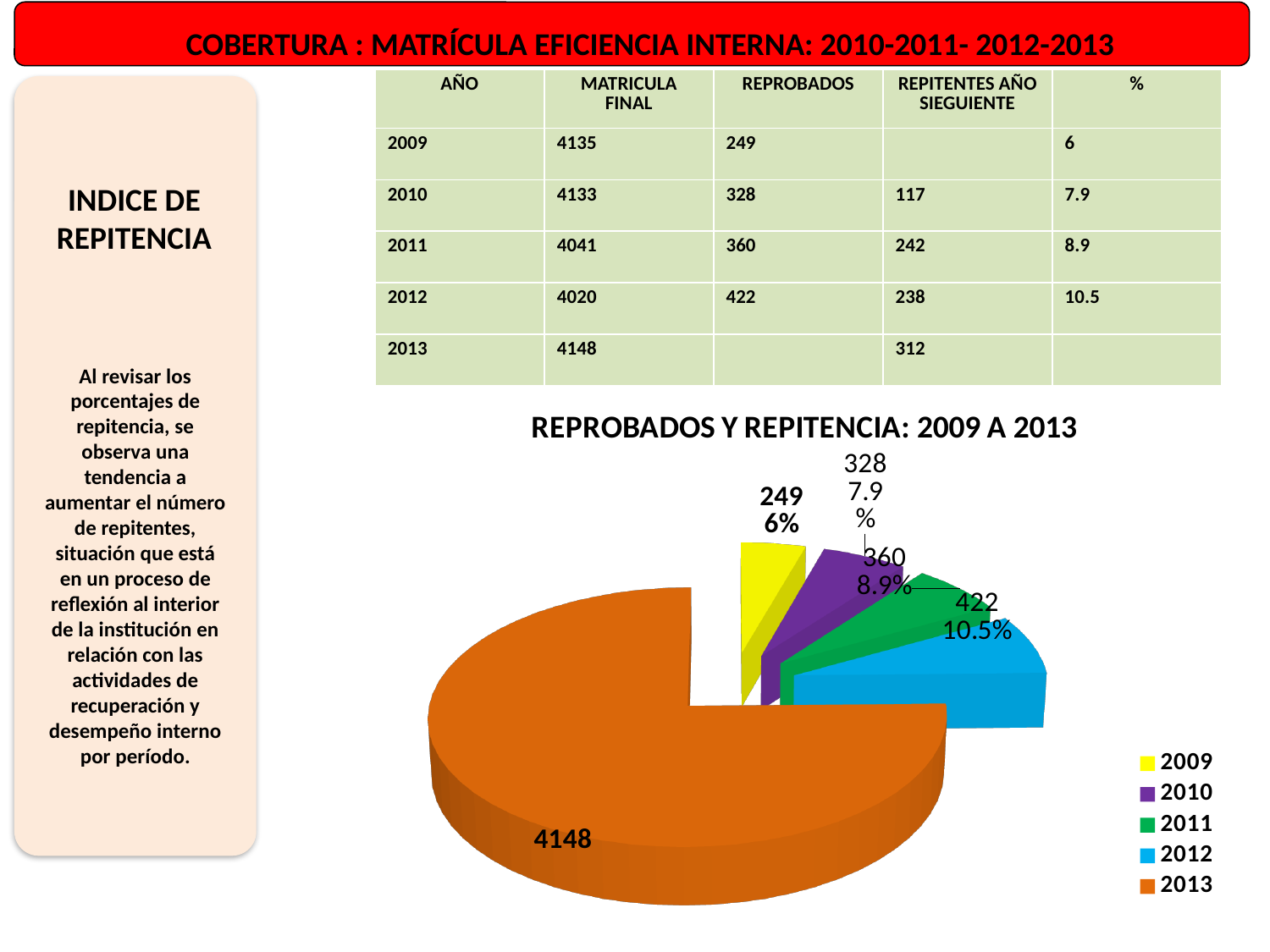
What value is labelled on the 2009 slice of the pie chart? 249 What is the difference between the values labelled for 2012 and 2009 in the pie chart? 173 What kind of chart is shown on the slide? pie chart How many entries does the legend of the pie chart list? 5 Which year has the largest slice in the pie chart? 2013 Which year has the smallest slice in the pie chart? 2009 What percentage is labelled on the 2011 slice of the pie chart? 8.9% How many slices does the pie chart have? 5 What value is labelled on the 2013 slice of the pie chart? 4148 What value is labelled on the 2012 slice of the pie chart? 422 What is the title of the pie chart? REPROBADOS Y REPITENCIA: 2009 A 2013 In the pie chart, which is larger, the value for 2010 or the value for 2011? 2011